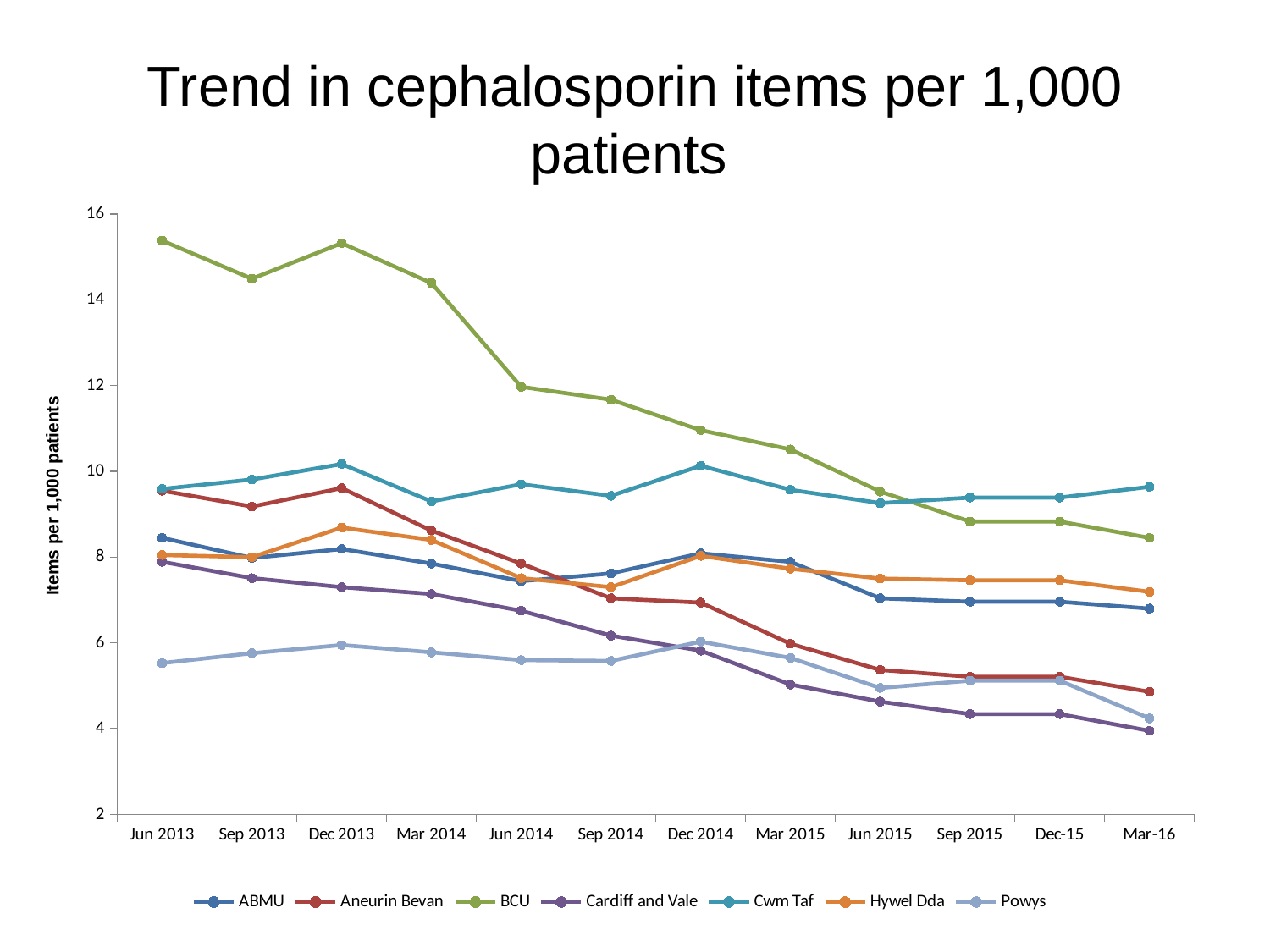
In Mar-16, which is larger: the value for Cwm Taf or the value for BCU? Cwm Taf Is the value for BCU in Mar-16 greater or less than 10? less How many time points are shown along the x axis? 12 How many series does the legend list? 7 Which series has the highest value in Mar-16? Cwm Taf Is the value for Powys in Jun 2013 greater or less than 6? less Which series has the lowest value in Jun 2013? Powys Which series has the highest value in Jun 2013? BCU What is the label on the vertical axis? Items per 1,000 patients What kind of chart is shown on the slide? line chart Is the value for BCU in Jun 2013 greater or less than 14? greater Does the BCU series rise or fall from Jun 2013 to Mar-16? fall